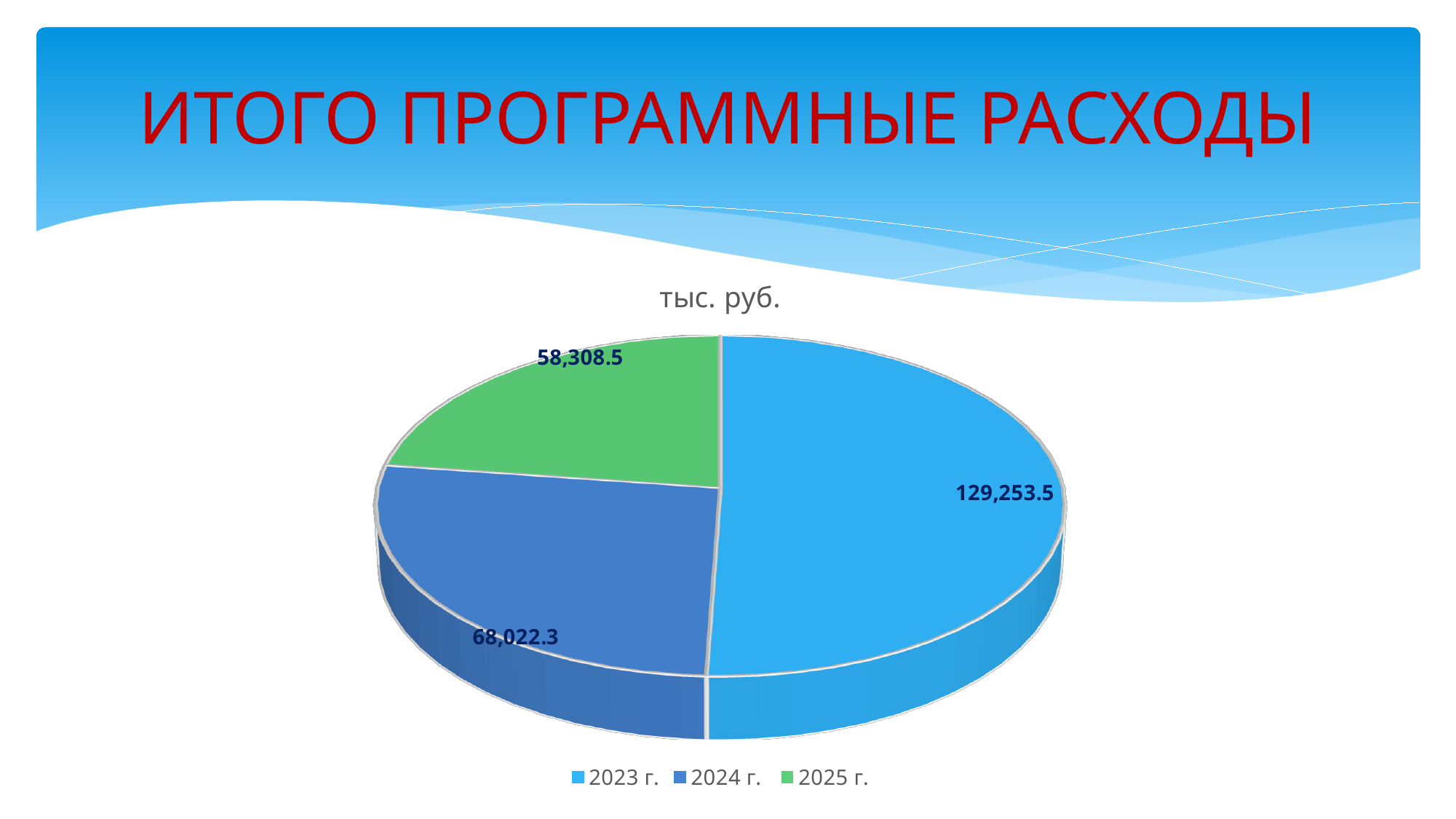
What is the difference between the values for 2023 г. and 2024 г.? 61,231.2 What is the difference between the values for 2024 г. and 2025 г.? 9,713.8 Which year has the largest slice in the pie chart? 2023 г. What is the value for 2024 г. in the pie chart? 68,022.3 What is the title of the pie chart? тыс. руб. What is the value for 2023 г. in the pie chart? 129,253.5 What is the value for 2025 г. in the pie chart? 58,308.5 Which is larger, the value for 2024 г. or the value for 2025 г.? 2024 г. What kind of chart is shown on the slide? Pie chart How many slices does the pie chart have? 3 Which year has the smallest slice in the pie chart? 2025 г. What colour is the slice for 2025 г. in the pie chart? Green